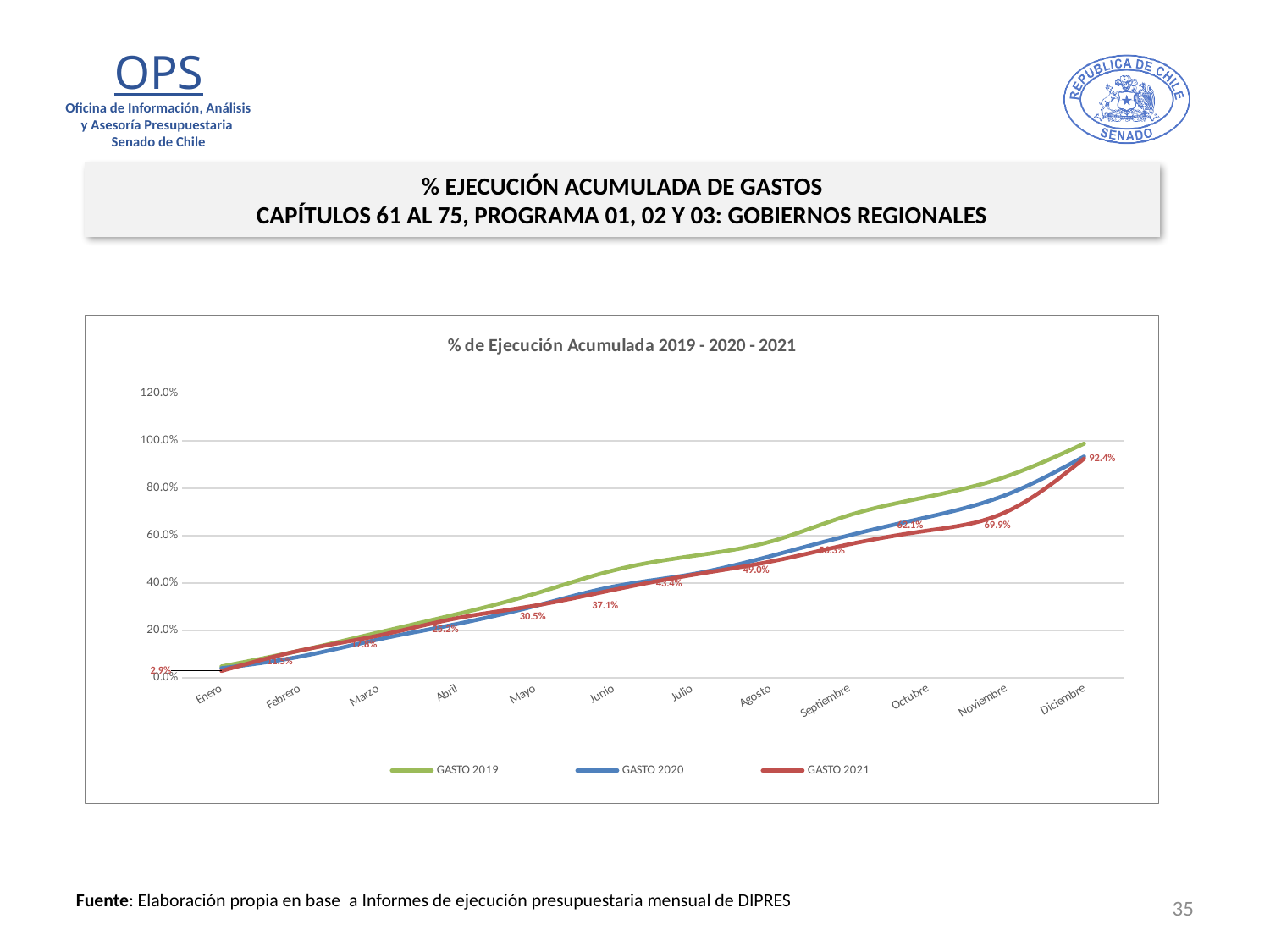
What is the value for GASTO 2021 in Noviembre? 69.9% Do the values of the GASTO 2021 series rise or fall from Enero to Diciembre? rise What is the value for GASTO 2021 in Junio? 37.1% What is the value for GASTO 2021 in Mayo? 30.5% How many months are plotted along the x axis? 12 Which series has the highest value in Diciembre? GASTO 2019 What is the value for GASTO 2021 in Agosto? 49.0% Is the value for GASTO 2019 in Diciembre greater or less than 80%? greater What kind of chart is shown on the slide? line chart What is the value for GASTO 2021 in Diciembre? 92.4% How many series does the legend list? 3 By how much did GASTO 2021 increase from Noviembre to Diciembre? 22.5%